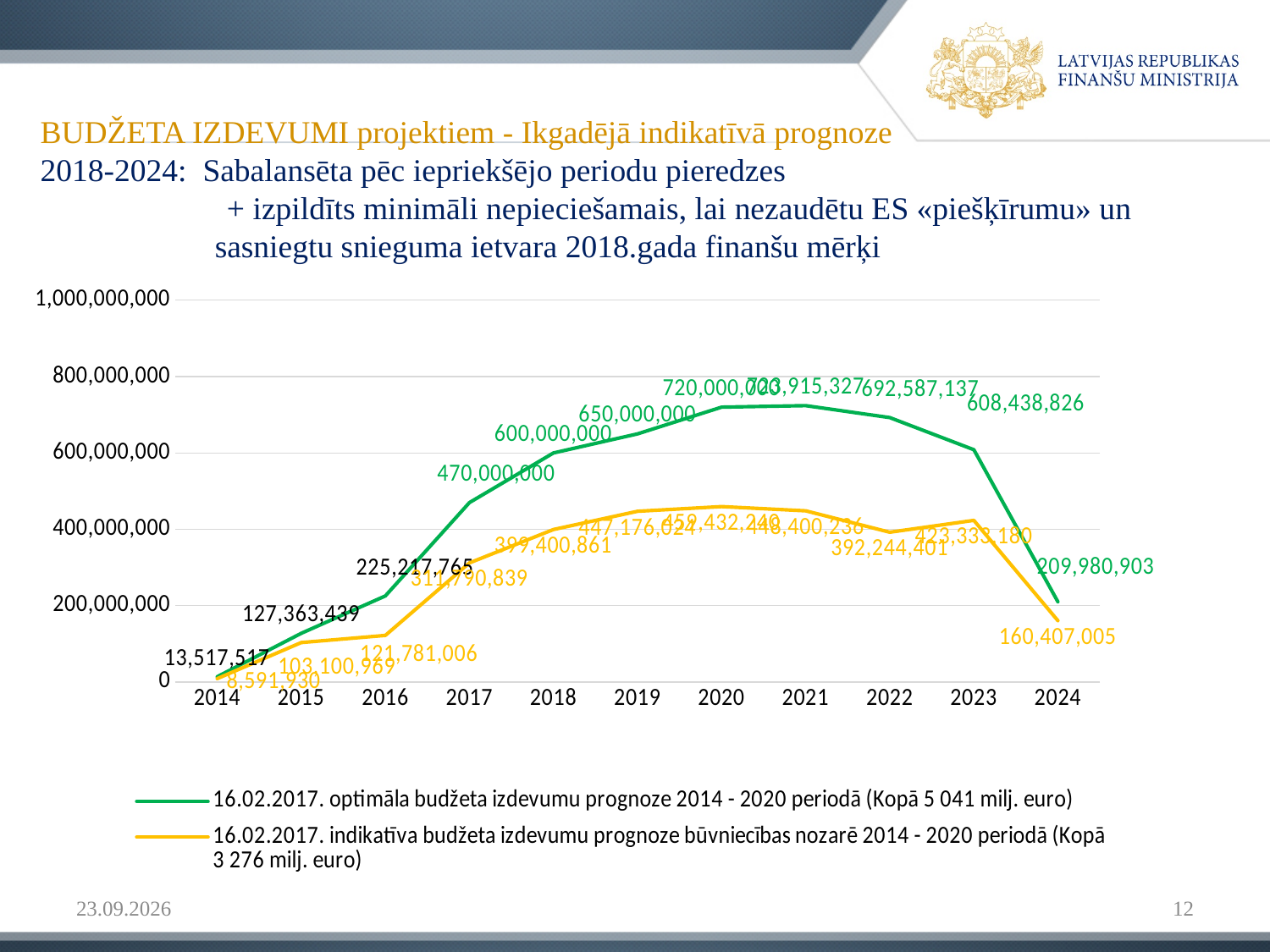
What is the difference between the green line's values for 2018 and 2017? 130,000,000 How many series does the legend list? 2 Does the green line rise or fall from 2014 to 2020? rise Is the green line's value for 2017 greater or less than 400,000,000? greater What is the value of the optimāla budžeta izdevumu prognoze (green line) for 2024? 209,980,903 What is the value of the indikatīva budžeta izdevumu prognoze būvniecības nozarē (yellow line) for 2022? 392,244,401 How many years are shown on the x axis? 11 What is the value of the indikatīva budžeta izdevumu prognoze būvniecības nozarē (yellow line) for 2024? 160,407,005 In which year is the optimāla budžeta izdevumu prognoze (green line) lowest? 2014 What is the value of the optimāla budžeta izdevumu prognoze (green line) for 2018? 600,000,000 What kind of chart is shown on the slide? line chart For 2023, which series has the larger value, the green optimāla prognoze or the yellow indikatīva prognoze? green optimāla prognoze